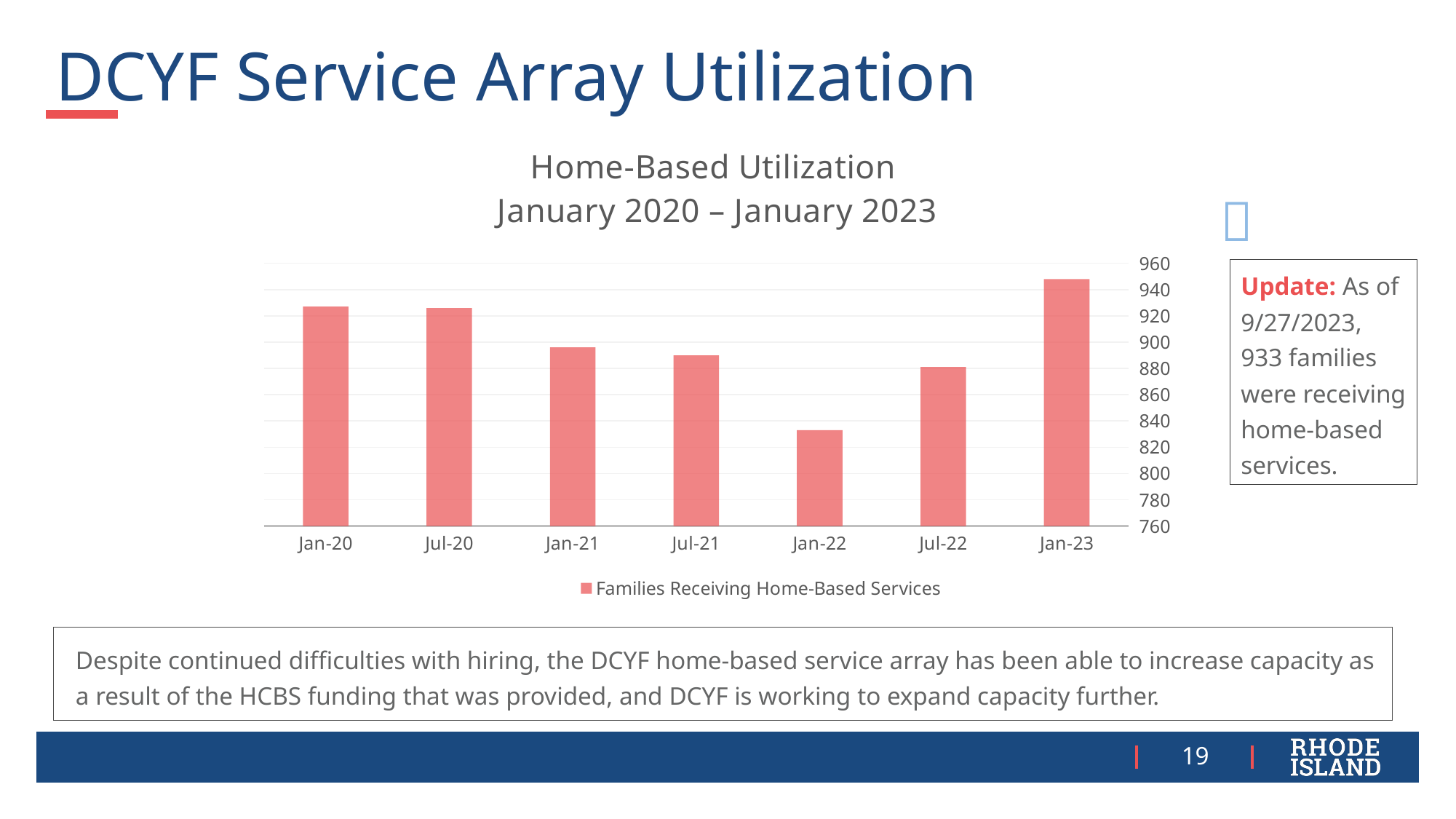
What kind of chart is shown on the slide? bar chart Is the value for Jul-22 greater or less than 860? greater How many time periods are shown on the x axis of the Home-Based Utilization chart? 7 Which period has the lowest number of families receiving home-based services? Jan-22 Is the value for Jan-22 greater or less than 860? less Which period has the highest number of families receiving home-based services? Jan-23 From Jan-22 to Jan-23, do the values rise or fall? rise Is the value for Jan-23 greater or less than 940? greater Which is larger, the value for Jan-22 or the value for Jul-22? Jul-22 What is the legend entry for the series plotted in the chart? Families Receiving Home-Based Services How many series does the legend of the chart list? 1